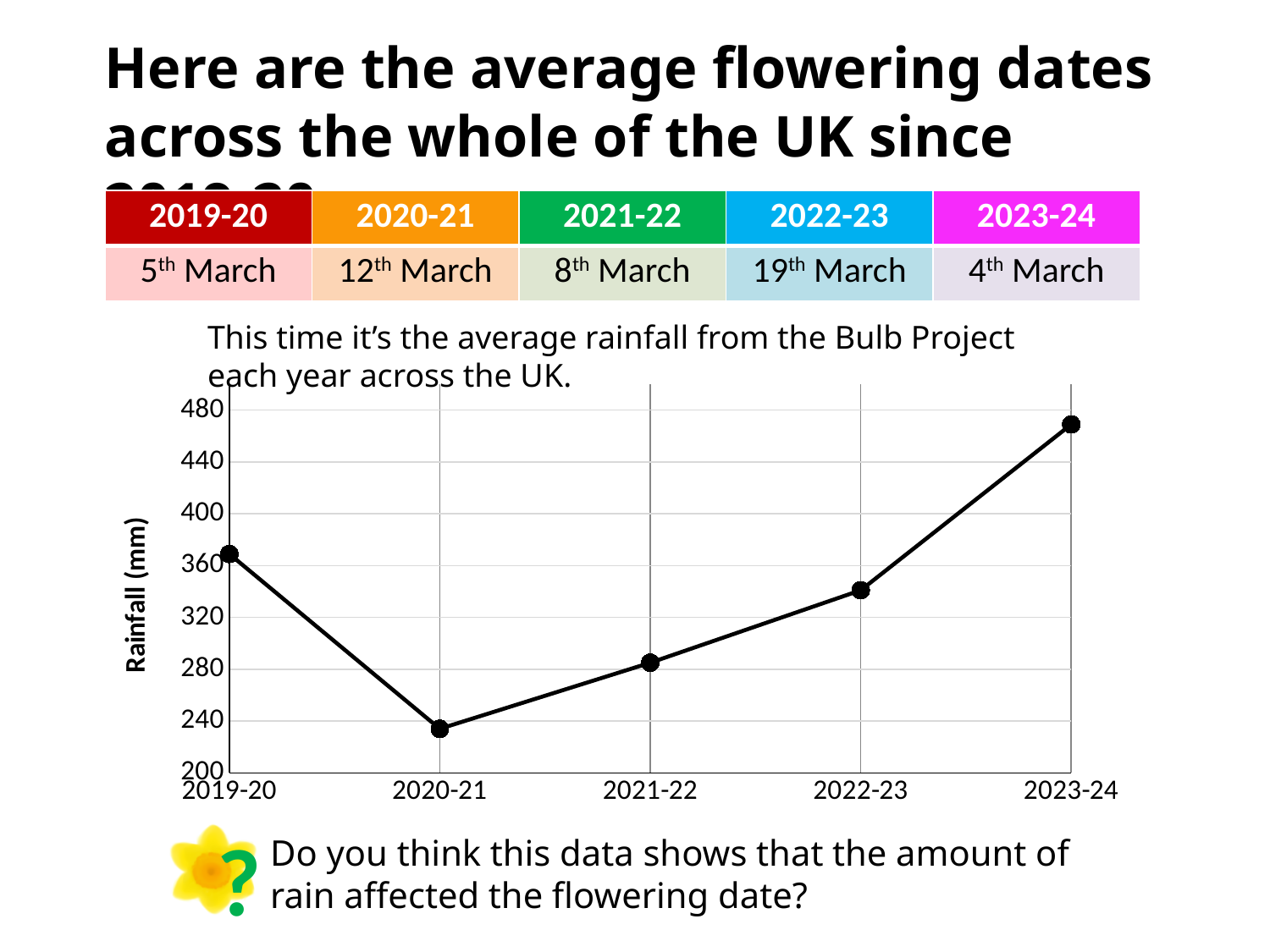
Is the rainfall value for 2020-21 greater or less than 240? less Which year has the lowest average rainfall on the chart? 2020-21 Is the rainfall value for 2021-22 greater or less than 320? less Is the rainfall value for 2023-24 greater or less than 440? greater What is the label on the vertical axis of the chart? Rainfall (mm) Do the rainfall values rise or fall from 2020-21 to 2023-24? rise How many data points are plotted on the rainfall chart? 5 Which year has higher rainfall, 2019-20 or 2021-22? 2019-20 Which year has the highest average rainfall on the chart? 2023-24 What kind of chart is shown on the slide? line chart